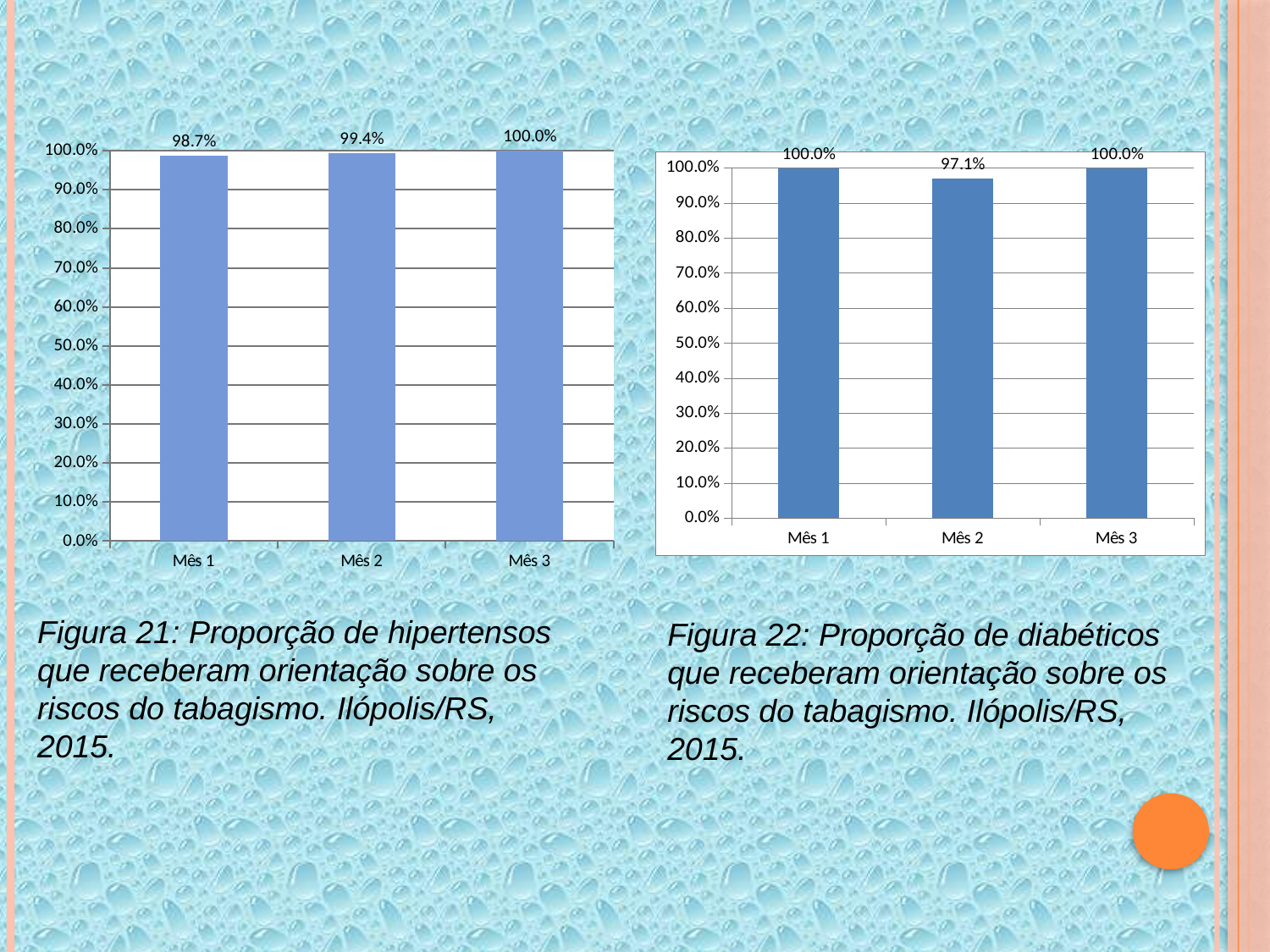
In the right chart (Figura 22, diabéticos), what is the value for Mês 2? 97.1% Which is larger: Mês 2 in the left chart (Figura 21) or Mês 2 in the right chart (Figura 22)? Mês 2 in the left chart (Figura 21) In the left chart (Figura 21, hipertensos), how many months are shown? 3 In the left chart (Figura 21, hipertensos), do the values rise or fall from Mês 1 to Mês 3? rise What kind of chart is the right chart (Figura 22, diabéticos)? bar chart In the left chart (Figura 21, hipertensos), which month has the lowest value? Mês 1 In the left chart (Figura 21, hipertensos), what is the value for Mês 2? 99.4% In the right chart (Figura 22, diabéticos), is the value for Mês 2 greater or less than 90.0%? greater In the right chart (Figura 22, diabéticos), which month has the lowest value? Mês 2 In the right chart (Figura 22, diabéticos), what is the difference between Mês 1 and Mês 2? 2.9% In the left chart (Figura 21, hipertensos), what is the value for Mês 1? 98.7% In the left chart (Figura 21, hipertensos), what is the difference between Mês 3 and Mês 1? 1.3%